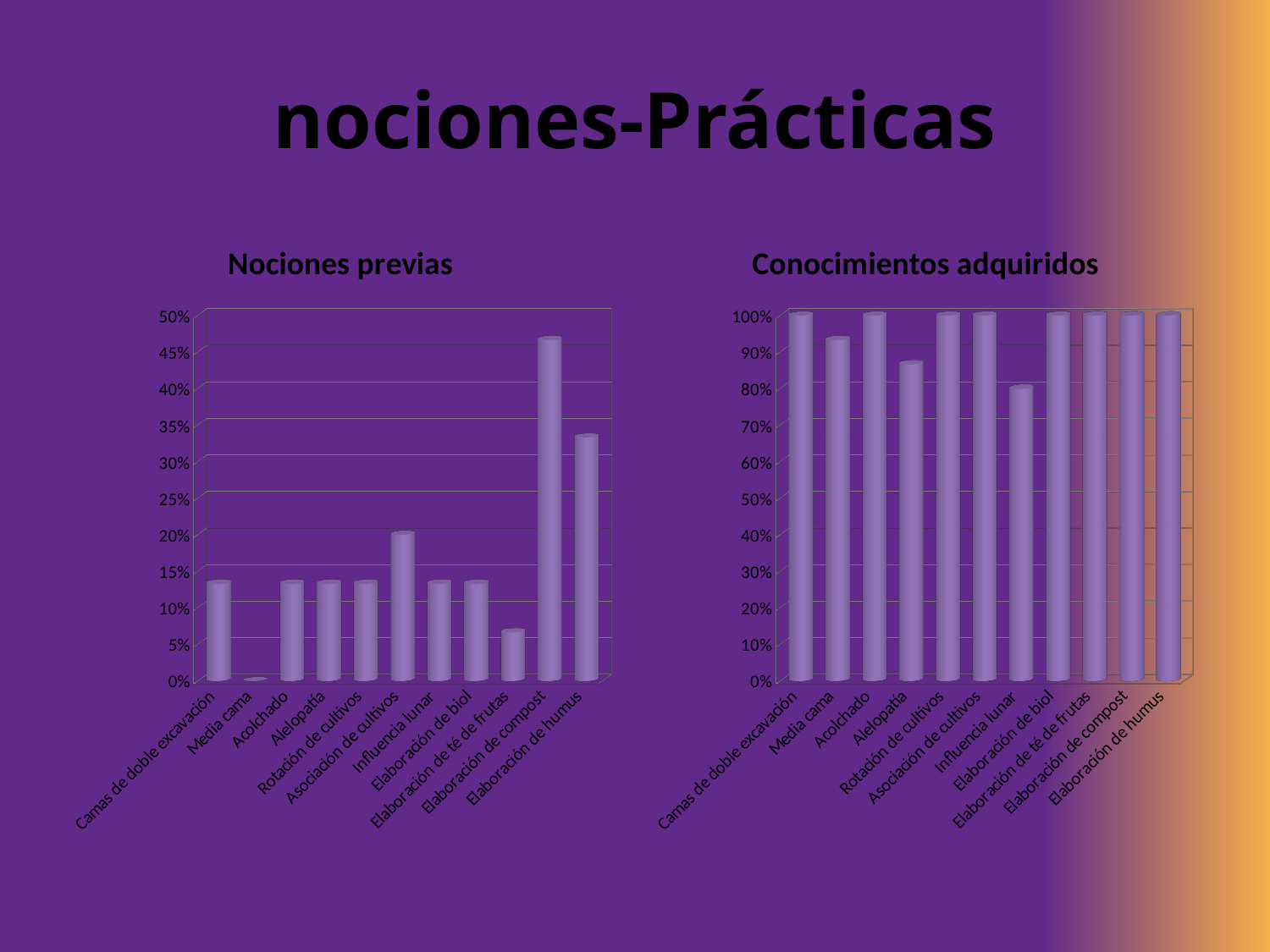
What is the title of the chart on the right side of the slide? Conocimientos adquiridos In the 'Conocimientos adquiridos' chart, is the value for Alelopatía greater or less than 90%? less In the 'Nociones previas' chart, is the value for Elaboración de compost greater or less than 40%? greater In the 'Nociones previas' chart, is the value for Elaboración de té de frutas greater or less than 10%? less In the 'Nociones previas' chart, which category has the lowest value? Media cama In the 'Conocimientos adquiridos' chart, which category has the lowest value? Influencia lunar How many categories are shown on the 'Nociones previas' chart? 11 In the 'Nociones previas' chart, which category has the highest value? Elaboración de compost In the 'Nociones previas' chart, which is larger: Elaboración de humus or Asociación de cultivos? Elaboración de humus What kind of chart is the 'Nociones previas' chart? bar chart In the 'Nociones previas' chart, what is the value for Media cama? 0%